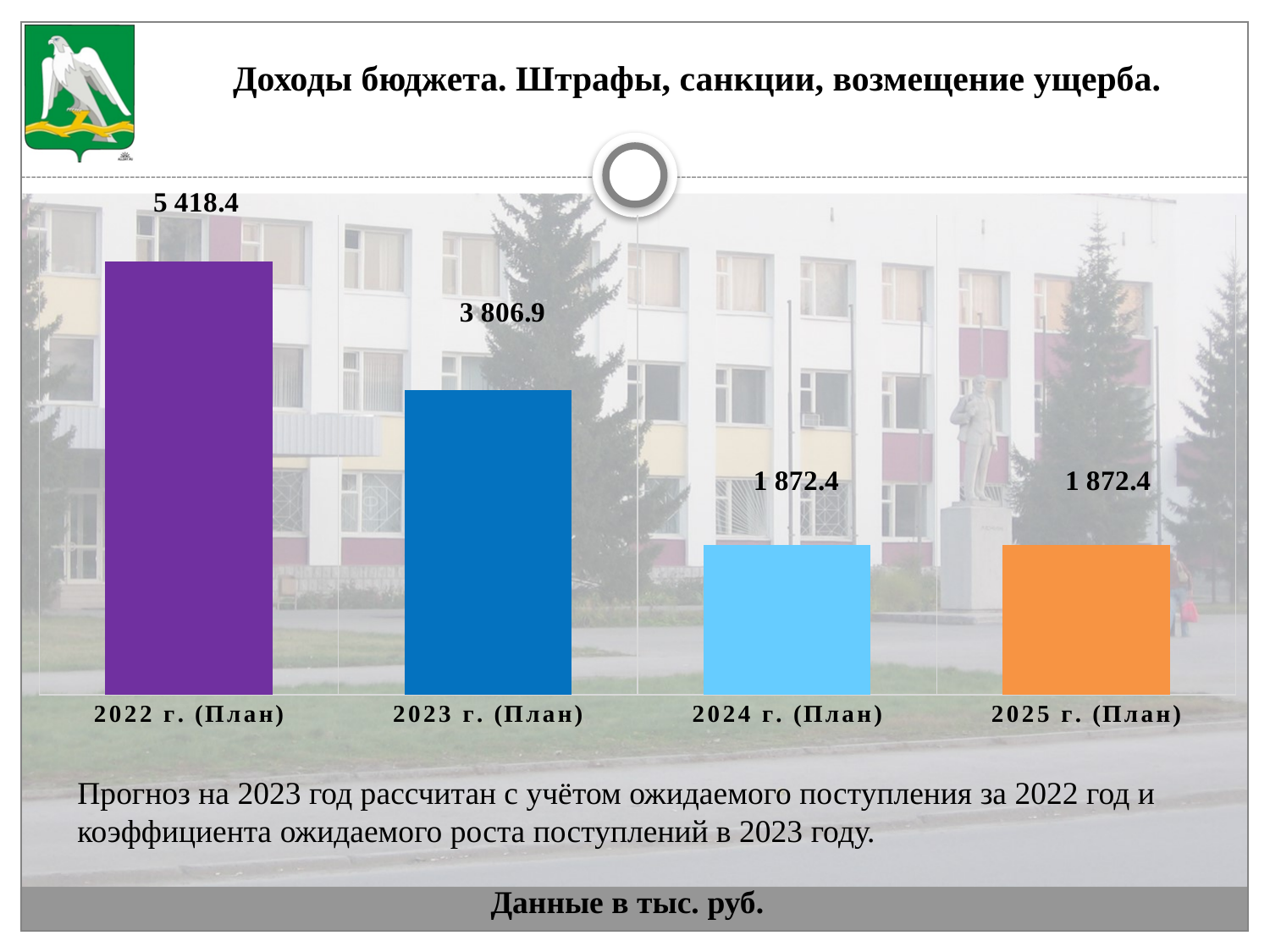
In what units are the chart's data given, according to the slide? тыс. руб. What is the value for 2024 г. (План)? 1 872.4 What is the difference between the values for 2022 г. (План) and 2023 г. (План)? 1 611.5 Which is larger, the value for 2023 г. (План) or the value for 2025 г. (План)? 2023 г. (План) What is the value for 2025 г. (План)? 1 872.4 What is the value for 2022 г. (План)? 5 418.4 What is the difference between the values for 2023 г. (План) and 2024 г. (План)? 1 934.5 Which category has the highest value? 2022 г. (План) Do the values rise or fall from 2022 г. (План) to 2024 г. (План)? fall What kind of chart is shown on the slide? bar chart How many categories are shown on the chart? 4 What is the value for 2023 г. (План)? 3 806.9